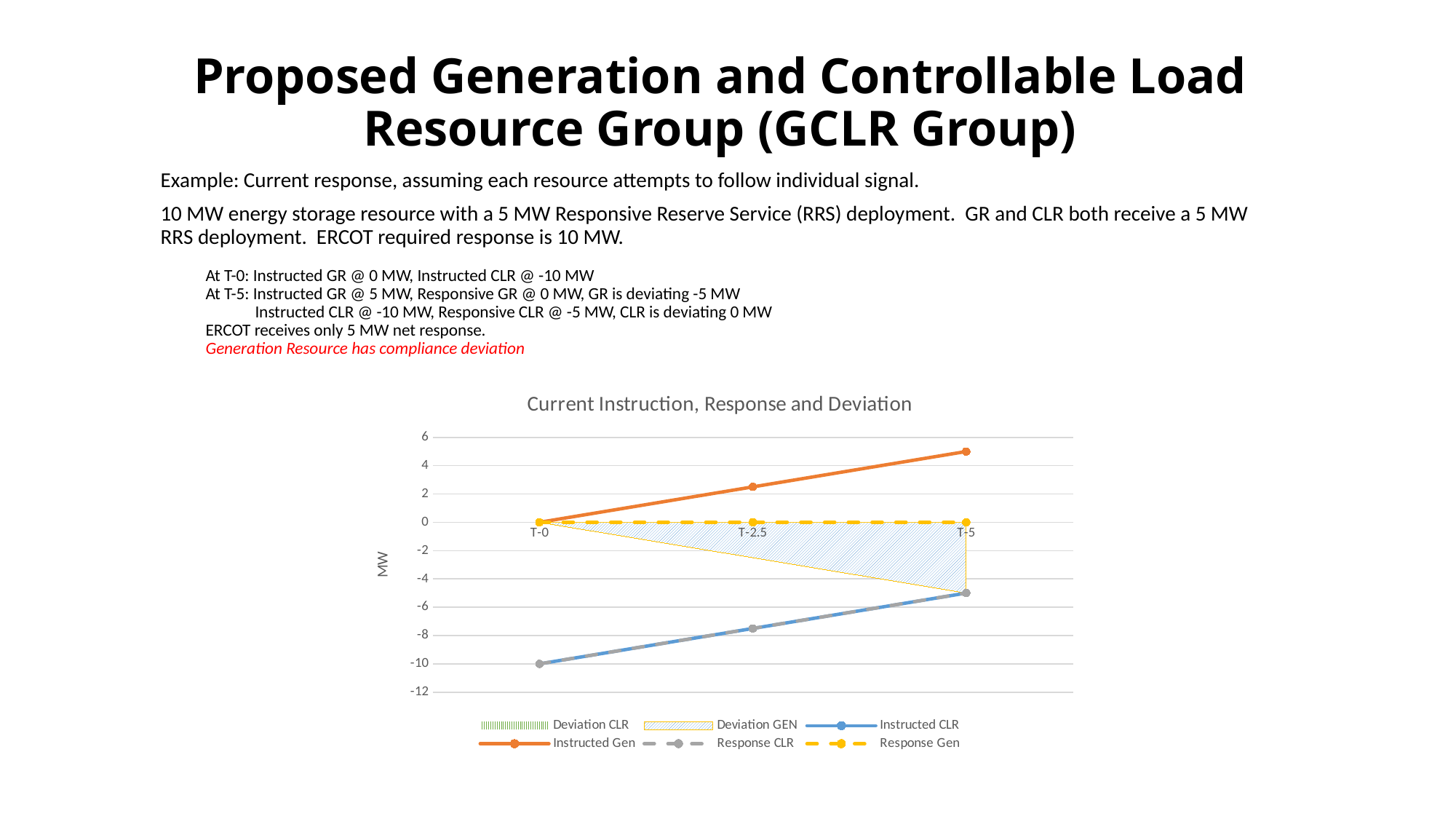
What is the value of Response Gen at T-5? 0 Is the value for Instructed CLR at T-5 greater or less than -4? less How many series does the chart legend list? 6 Is the value for Instructed CLR at T-2.5 greater or less than -6? less How many time points are shown on the x axis of the chart? 3 What is the value of Instructed Gen at T-0? 0 What is the value of Instructed CLR at T-0? -10 What kind of chart is shown on the slide? combination line and area chart What is the title of the chart? Current Instruction, Response and Deviation At T-2.5, which is larger: Instructed Gen or Instructed CLR? Instructed Gen Does the Instructed Gen series rise or fall from T-0 to T-5? rise Is the value for Instructed Gen at T-5 greater or less than 4? greater